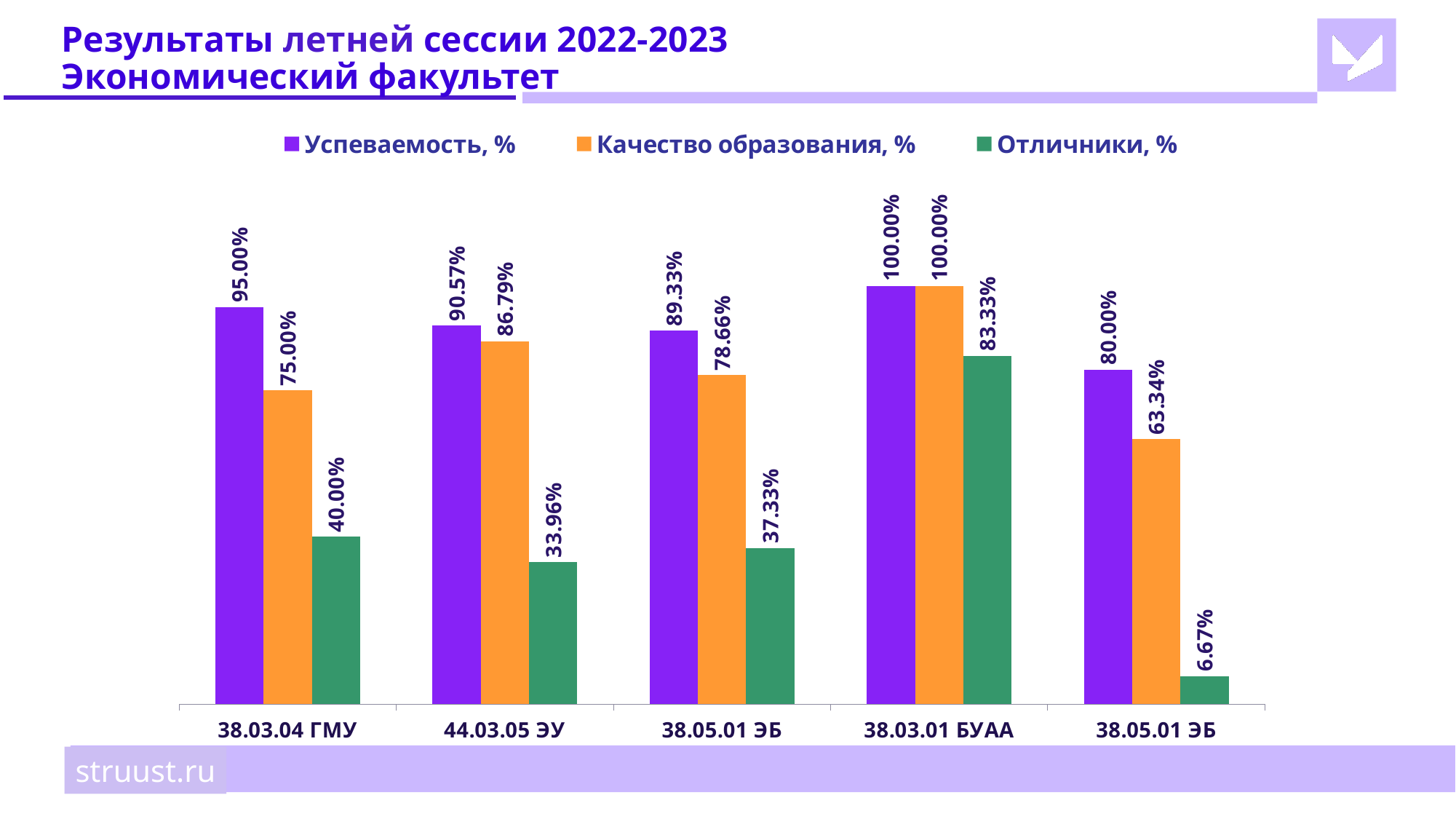
What kind of chart is shown on the slide? Bar chart What is the difference between Качество образования, % and Отличники, % for 38.03.01 БУАА? 16.67% What is the value of Качество образования, % for 44.03.05 ЭУ? 86.79% How many series does the legend list? 3 What is the value of Отличники, % for 44.03.05 ЭУ? 33.96% What is the value of Отличники, % for 38.03.01 БУАА? 83.33% How many category groups are shown on the x axis? 5 What is the difference between Успеваемость, % and Качество образования, % for 38.03.04 ГМУ? 20.00% Which category has the highest value of Отличники, %? 38.03.01 БУАА Which category group has the lowest value of Отличники, %? 38.05.01 ЭБ (the rightmost group) Which has a higher Качество образования, %: 44.03.05 ЭУ or 38.03.04 ГМУ? 44.03.05 ЭУ What is the value of Успеваемость, % for 38.03.04 ГМУ? 95.00%